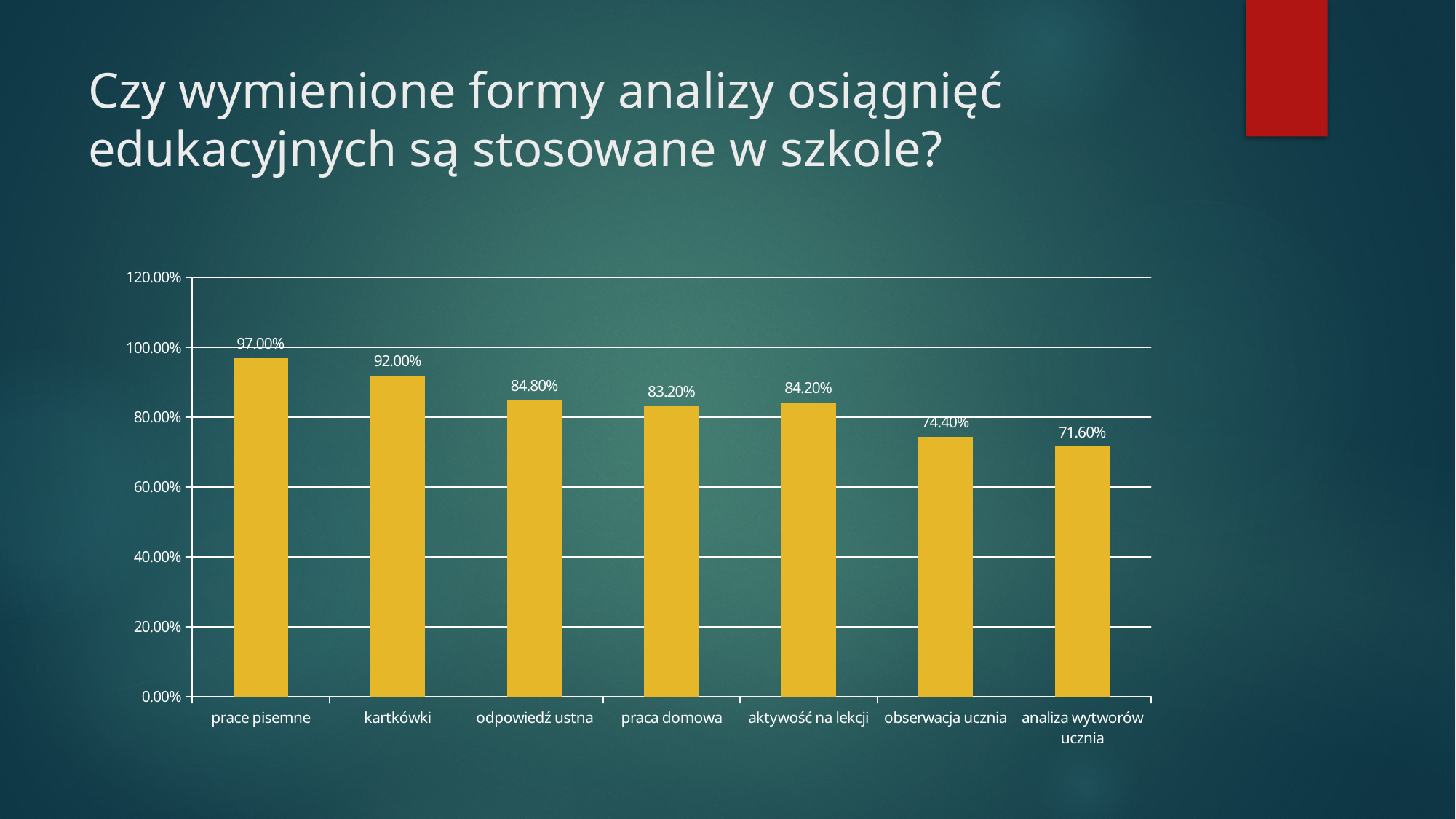
What is the difference between the values for prace pisemne and kartkówki? 5.00% Which category has the highest value? prace pisemne Do the values rise or fall overall from left to right along the x axis? fall What is the value for obserwacja ucznia? 74.40% What is the value for prace pisemne? 97.00% Which is larger, the value for kartkówki or the value for obserwacja ucznia? kartkówki What kind of chart is shown on the slide? bar chart What is the value for analiza wytworów ucznia? 71.60% How many categories are shown on the x axis? 7 What is the difference between the values for odpowiedź ustna and praca domowa? 1.60% What is the value for kartkówki? 92.00% Which category has the lowest value? analiza wytworów ucznia